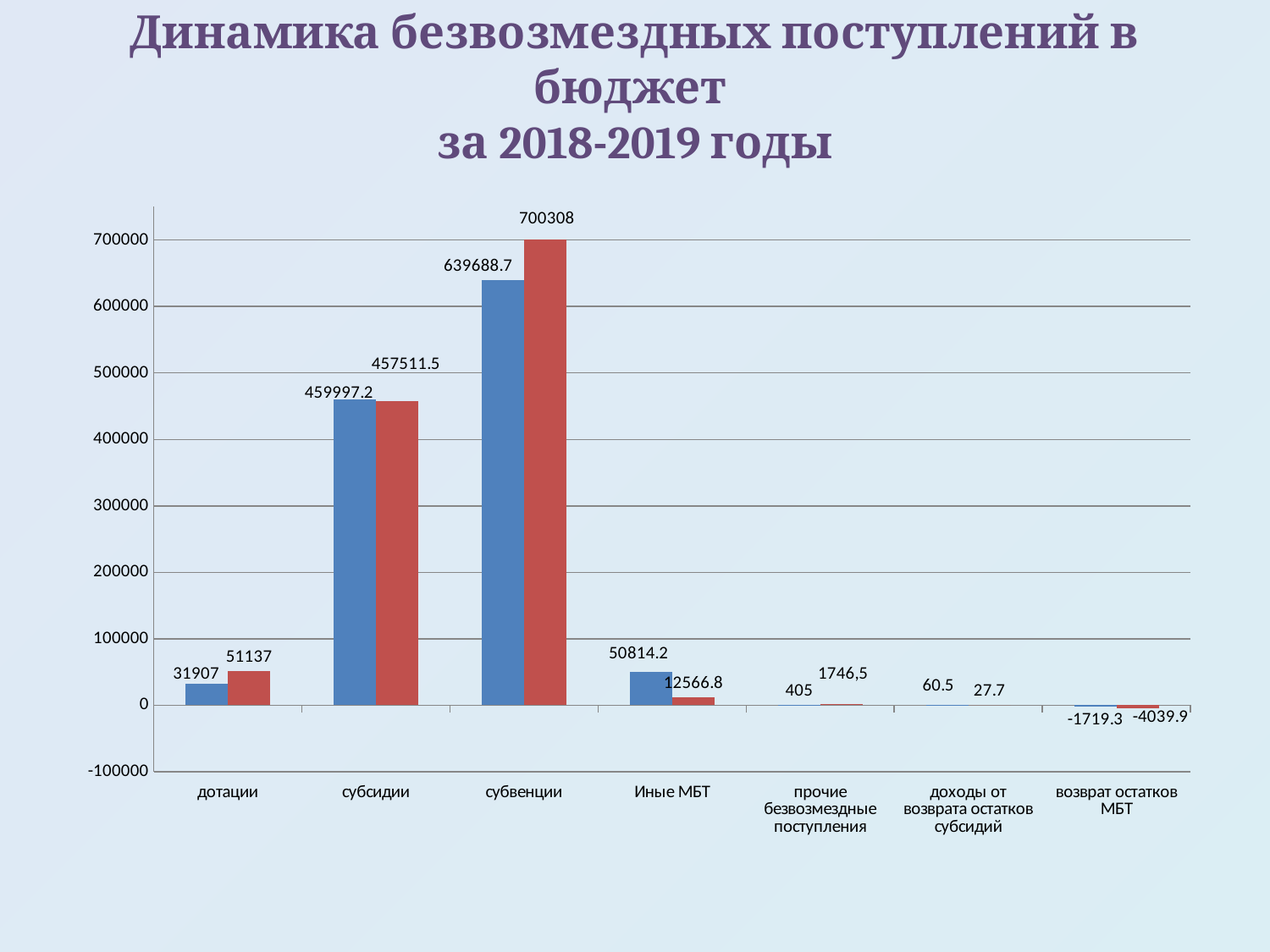
What is the value of the red bar for субвенции? 700308 Which category has the lowest blue bar? возврат остатков МБТ What is the value of the red bar for возврат остатков МБТ? -4039.9 For Иные МБТ, which bar is larger, the blue or the red? blue How many categories are shown on the x axis? 7 What is the value of the blue bar for субвенции? 639688.7 What is the value of the red bar for дотации? 51137 What kind of chart is shown on the slide? bar chart What is the value of the blue bar for Иные МБТ? 50814.2 What is the difference between the red and blue bars for дотации? 19230 What is the difference between the red and blue bars for субвенции? 60619.3 Which category has the highest red bar? субвенции